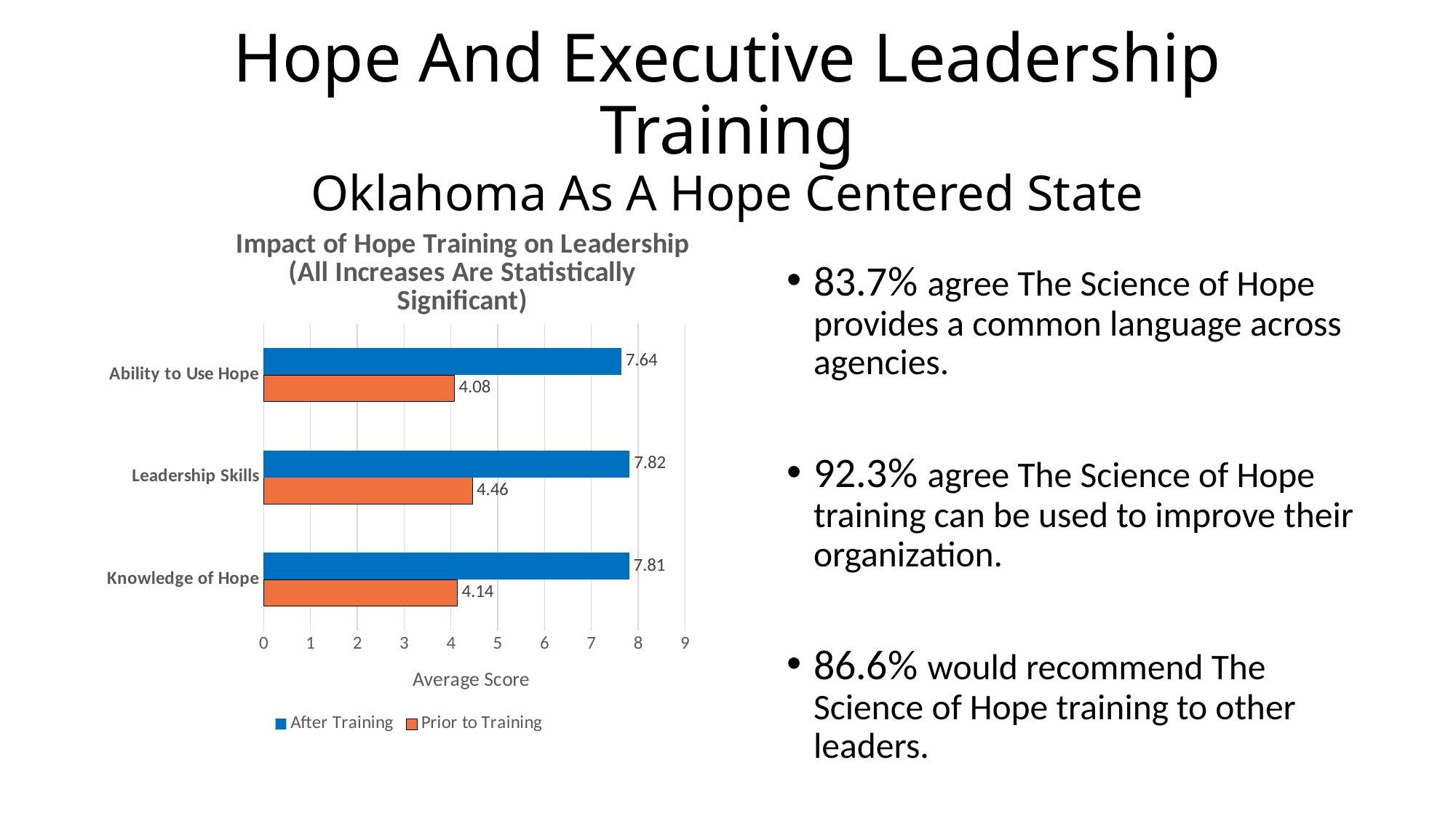
Which is larger: the Prior to Training score for Leadership Skills or for Ability to Use Hope? Leadership Skills What is the label of the horizontal axis of the chart? Average Score What is the After Training score for Ability to Use Hope? 7.64 How many categories are shown on the chart? 3 What is the Prior to Training score for Knowledge of Hope? 4.14 Which category has the lowest After Training score? Ability to Use Hope How many series does the legend list? 2 Which category has the highest Prior to Training score? Leadership Skills What is the Prior to Training score for Leadership Skills? 4.46 What is the difference between the After Training and Prior to Training scores for Ability to Use Hope? 3.56 What is the difference between the After Training and Prior to Training scores for Knowledge of Hope? 3.67 What kind of chart is shown on the slide? Bar chart